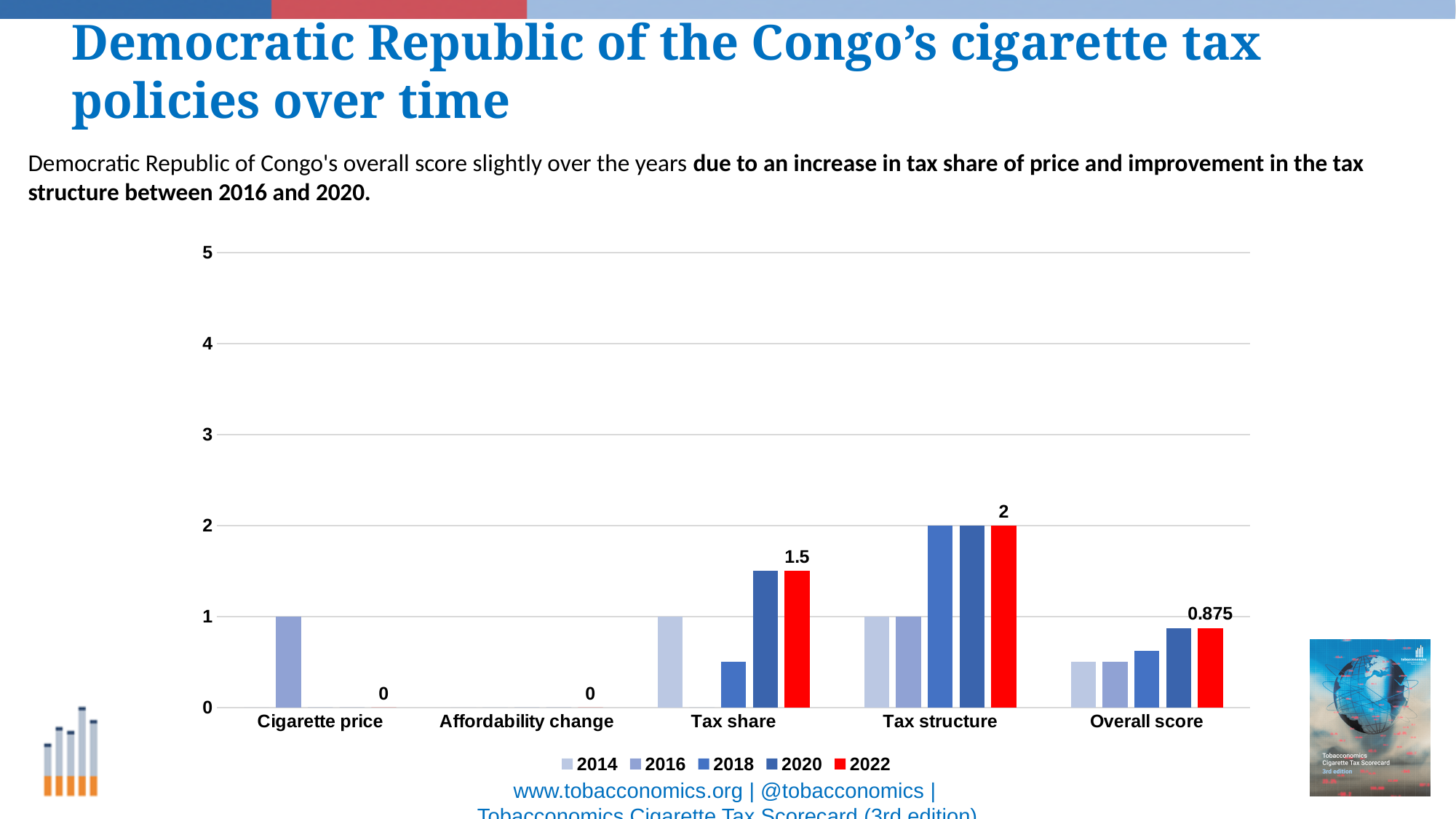
Which category has the highest 2022 value? Tax structure What is the 2016 value for Cigarette price? 1 How many categories are shown on the x axis? 5 What is the 2022 value for Tax structure? 2 What is the 2022 value for Overall score? 0.875 How many series does the legend list? 5 Is the 2018 value for Tax share greater or less than 1? less What kind of chart is shown on the slide? bar chart Which is larger in 2022: Tax share or Overall score? Tax share What is the difference between the 2022 values for Tax structure and Tax share? 0.5 What is the 2022 value for Cigarette price? 0 What is the 2022 value for Tax share? 1.5